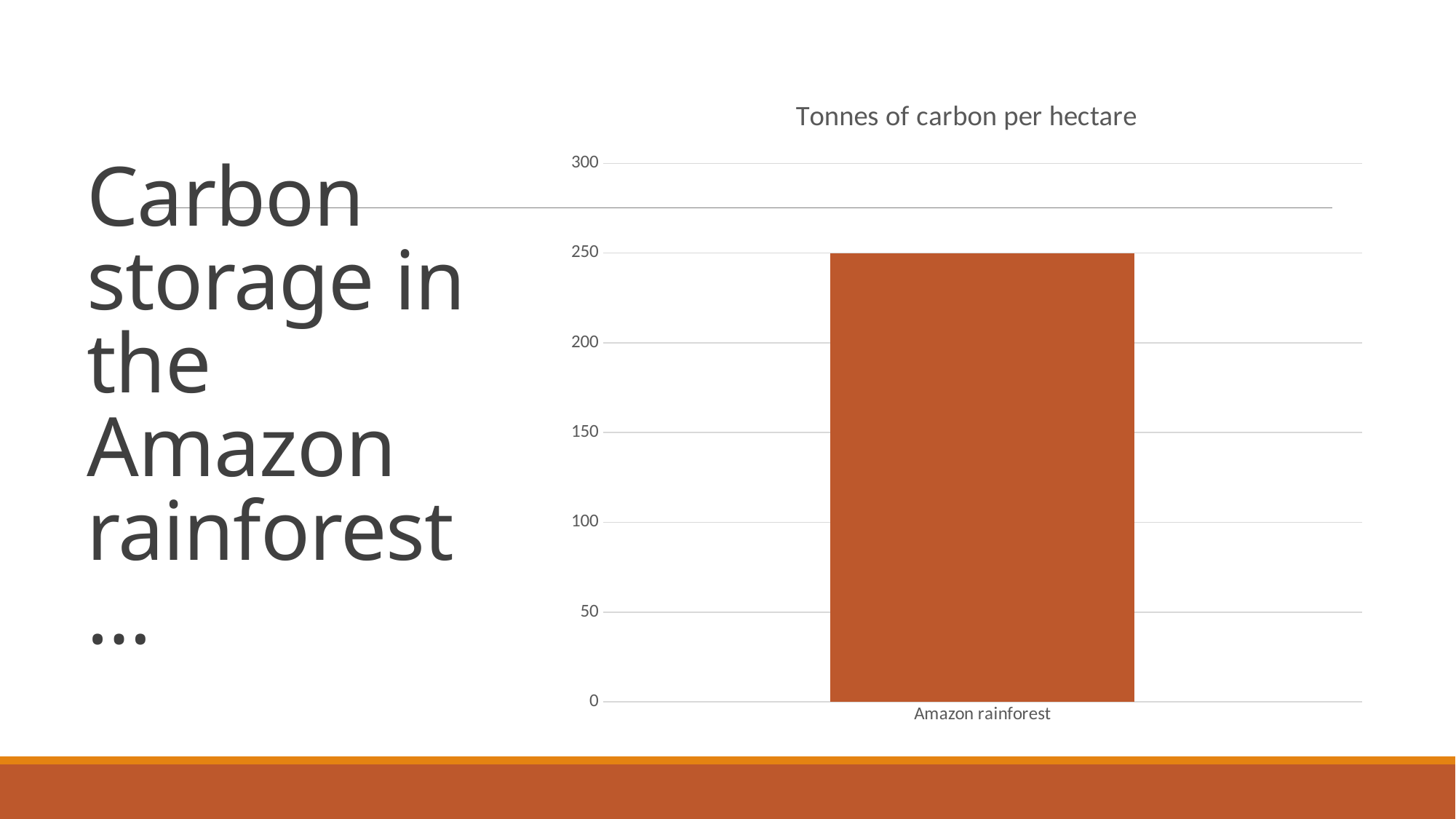
Is the value for Amazon rainforest greater or less than 200? greater What kind of chart is shown on the slide? bar chart What is the title of the chart? Tonnes of carbon per hectare What is the label of the only category on the x axis of the chart? Amazon rainforest What is the value for Amazon rainforest in the chart? 250 What is the highest value shown on the chart's vertical axis? 300 How many categories are plotted in the chart? 1 Is the value for Amazon rainforest greater or less than 300? less